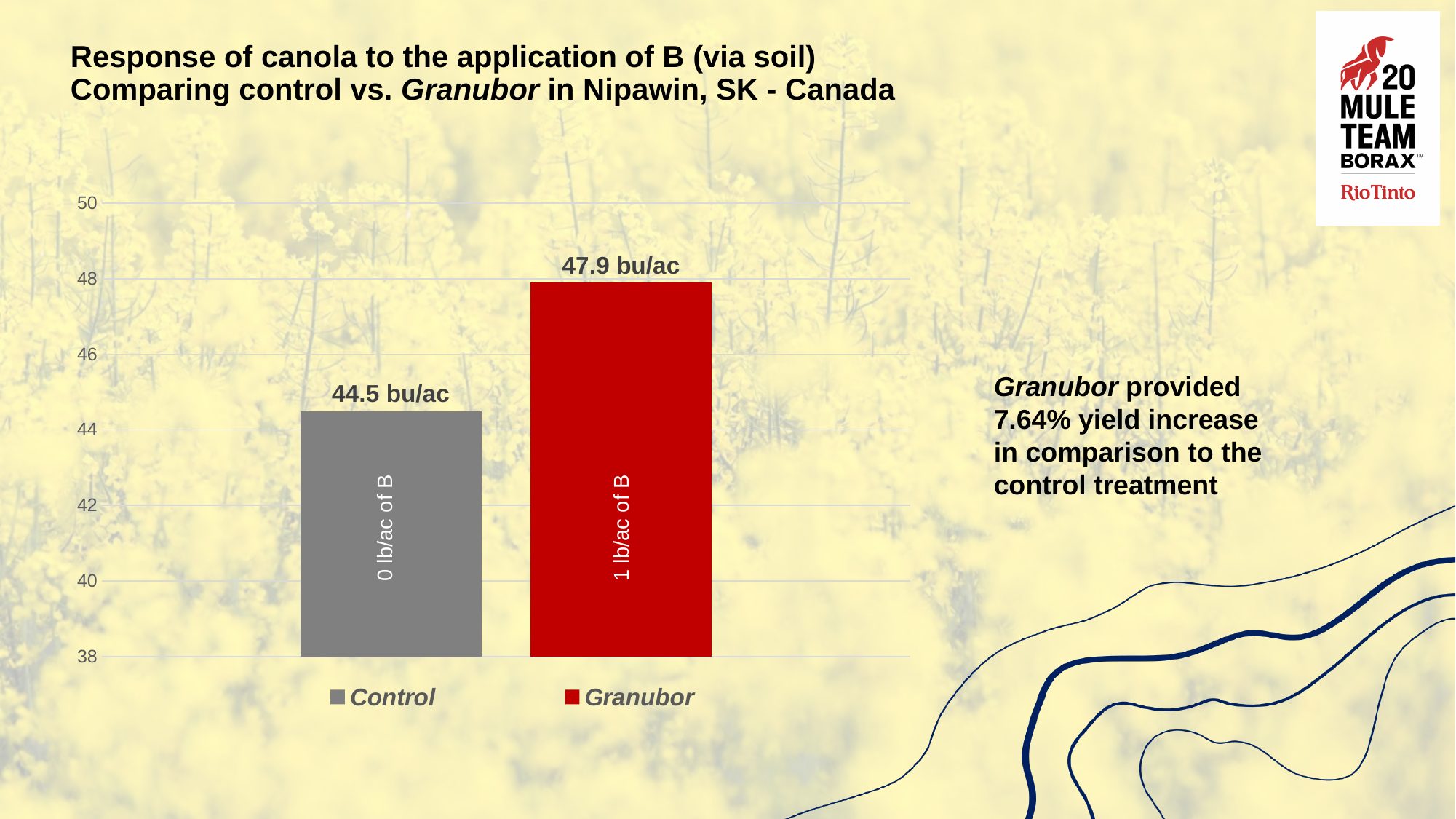
How many bars are plotted on the chart? 2 Which treatment has the lower yield? Control How many series does the legend list? 2 What kind of chart is shown on the slide? Bar chart Which treatment has the higher yield, Control or Granubor? Granubor What application rate of B is labelled on the Granubor bar? 1 lb/ac of B What is the yield value for the Granubor bar? 47.9 bu/ac What colour is the Granubor bar? Red Is the Granubor yield greater or less than 46? greater What is the difference in yield between Granubor and Control? 3.4 bu/ac Is the Control yield greater or less than 46? less What is the yield value for the Control bar? 44.5 bu/ac